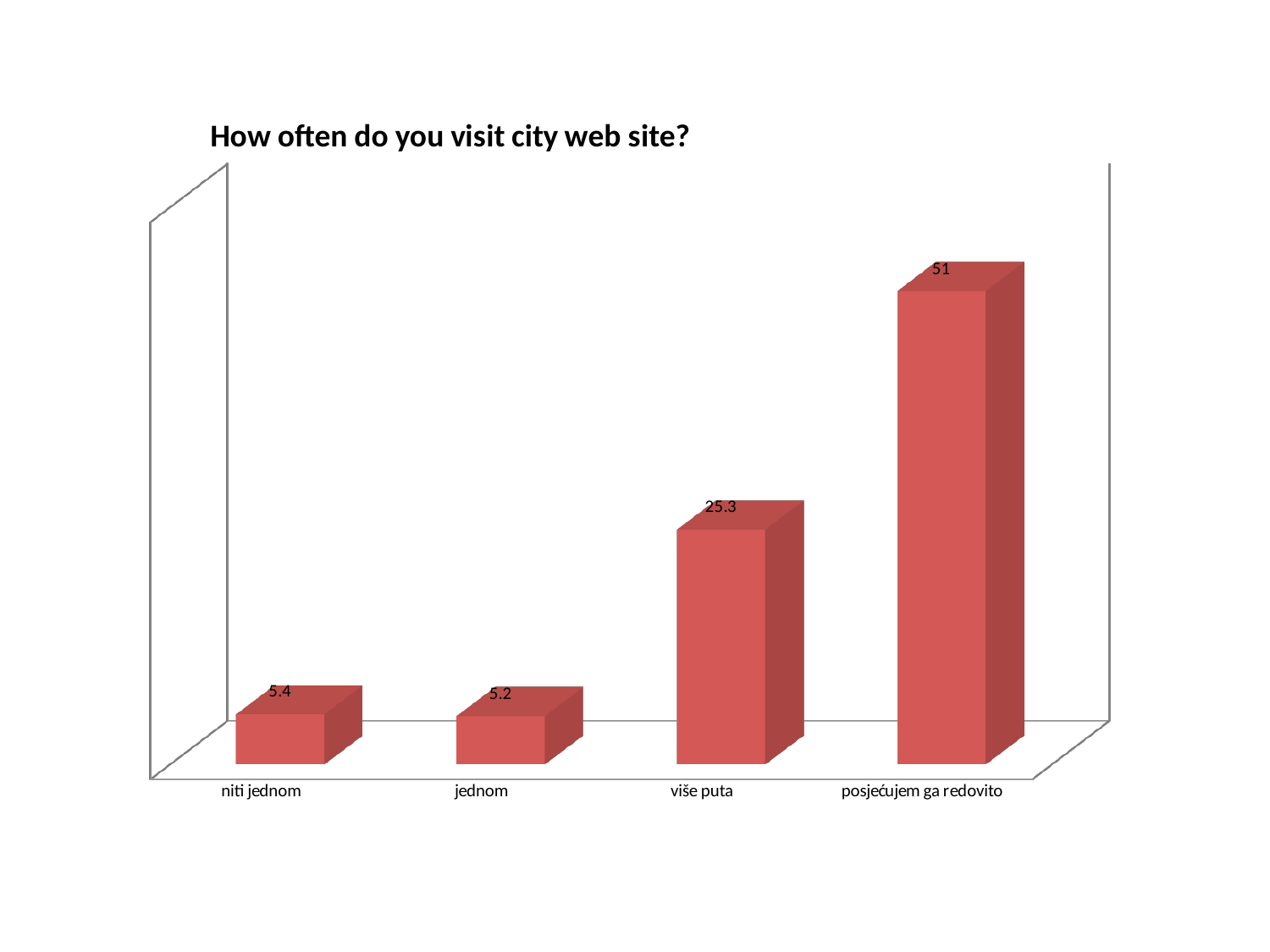
What is the value for "više puta"? 25.3 What is the value for "niti jednom"? 5.4 Which category has the highest value? posjećujem ga redovito Which is larger, the value for "više puta" or the value for "jednom"? više puta What is the value for "posjećujem ga redovito"? 51 What colour are the bars in the chart? red How many categories are shown on the chart? 4 What is the difference between the values for "niti jednom" and "jednom"? 0.2 What is the value for "jednom"? 5.2 What is the difference between the values for "posjećujem ga redovito" and "više puta"? 25.7 What kind of chart is shown on the slide? bar chart What is the title of the chart? How often do you visit city web site?